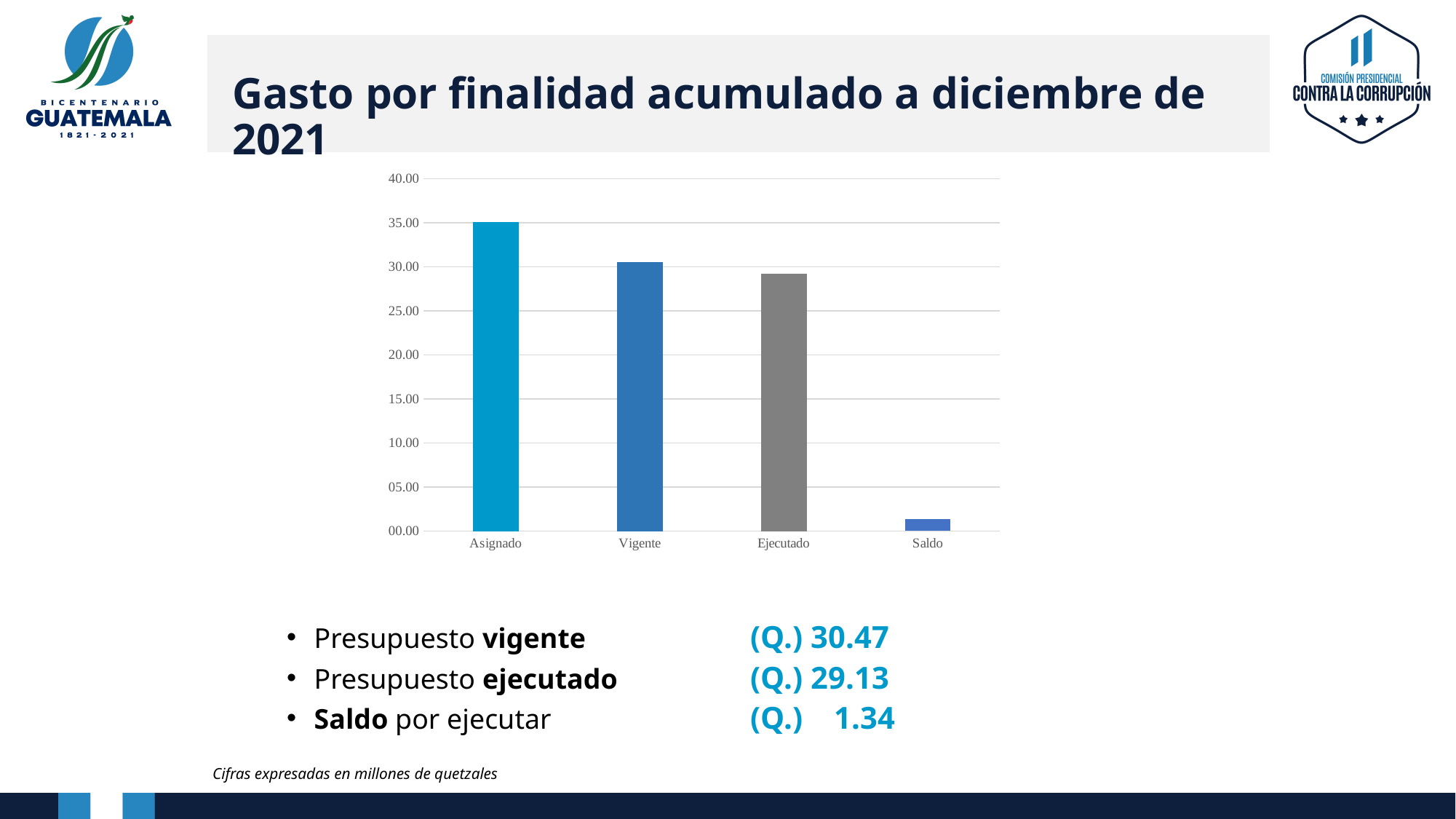
What kind of chart is shown on the slide? bar chart Which is larger, the bar for Vigente or the bar for Ejecutado? Vigente According to the slide, what is the value of the Vigente budget shown in the chart? 30.47 Is the value for Ejecutado greater or less than 25.00? greater Is the value for Asignado greater or less than 30.00? greater Which category has the lowest bar in the chart? Saldo According to the slide, what is the value of the Saldo shown in the chart? 1.34 Which category has the highest bar in the chart? Asignado Is the value for Saldo greater or less than 05.00? less How many categories are plotted on the x axis of the chart? 4 According to the slide, what is the value of the Ejecutado budget shown in the chart? 29.13 Do the bar values rise or fall from left to right across the x axis? fall